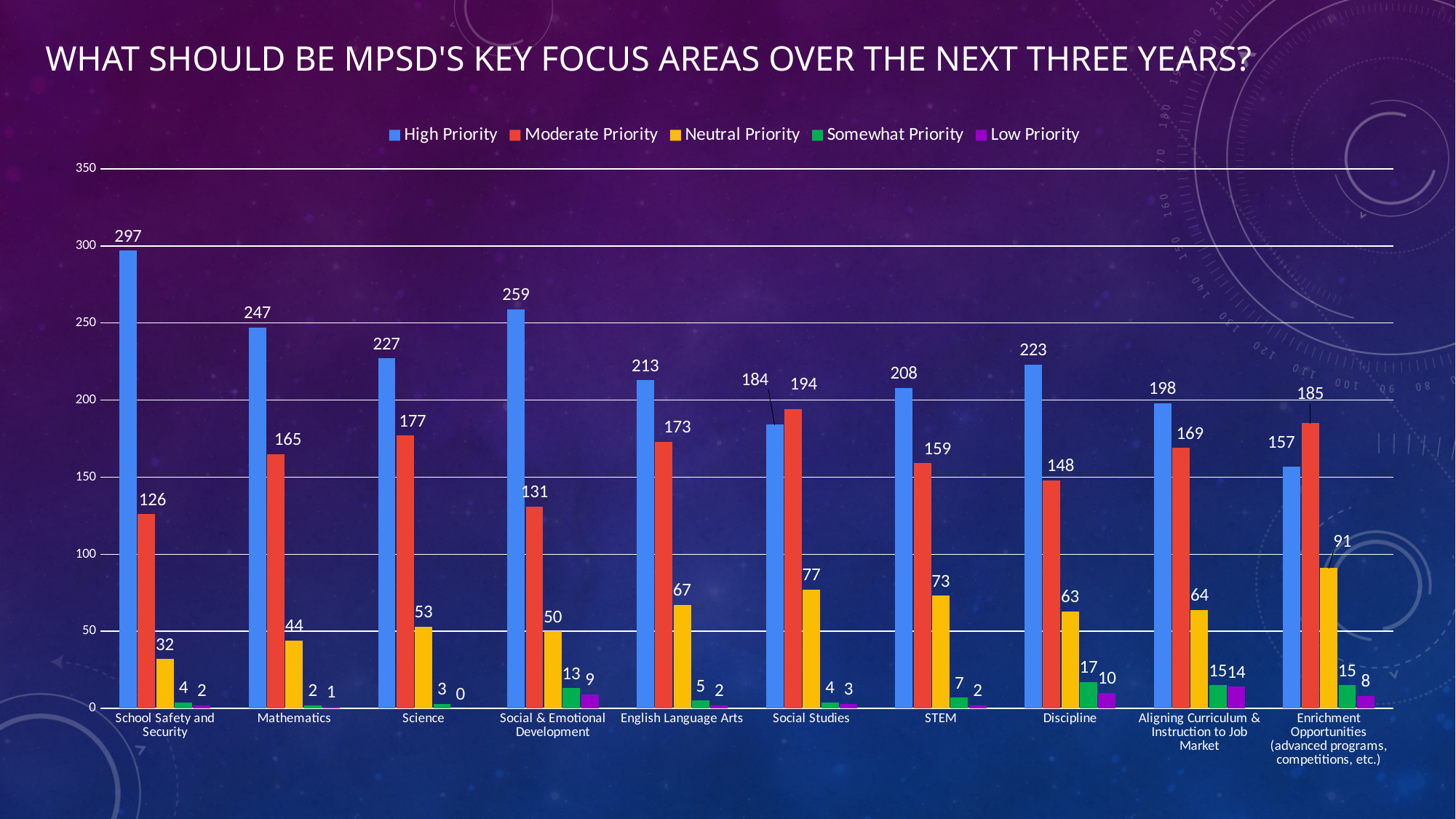
Which colour represents the Neutral Priority series in the legend? Yellow What kind of chart is shown on the slide? Bar chart How many series does the legend list? 5 What is the High Priority value for School Safety and Security? 297 Which category has the highest High Priority value? School Safety and Security What is the Neutral Priority value for Enrichment Opportunities (advanced programs, competitions, etc.)? 91 What is the Moderate Priority value for Social Studies? 194 Which category has the lowest High Priority value? Enrichment Opportunities (advanced programs, competitions, etc.) What is the difference between the High Priority and Moderate Priority values for Mathematics? 82 What is the Low Priority value for Science? 0 How many categories are shown on the x axis? 10 For Social Studies, which is larger: the High Priority value or the Moderate Priority value? Moderate Priority